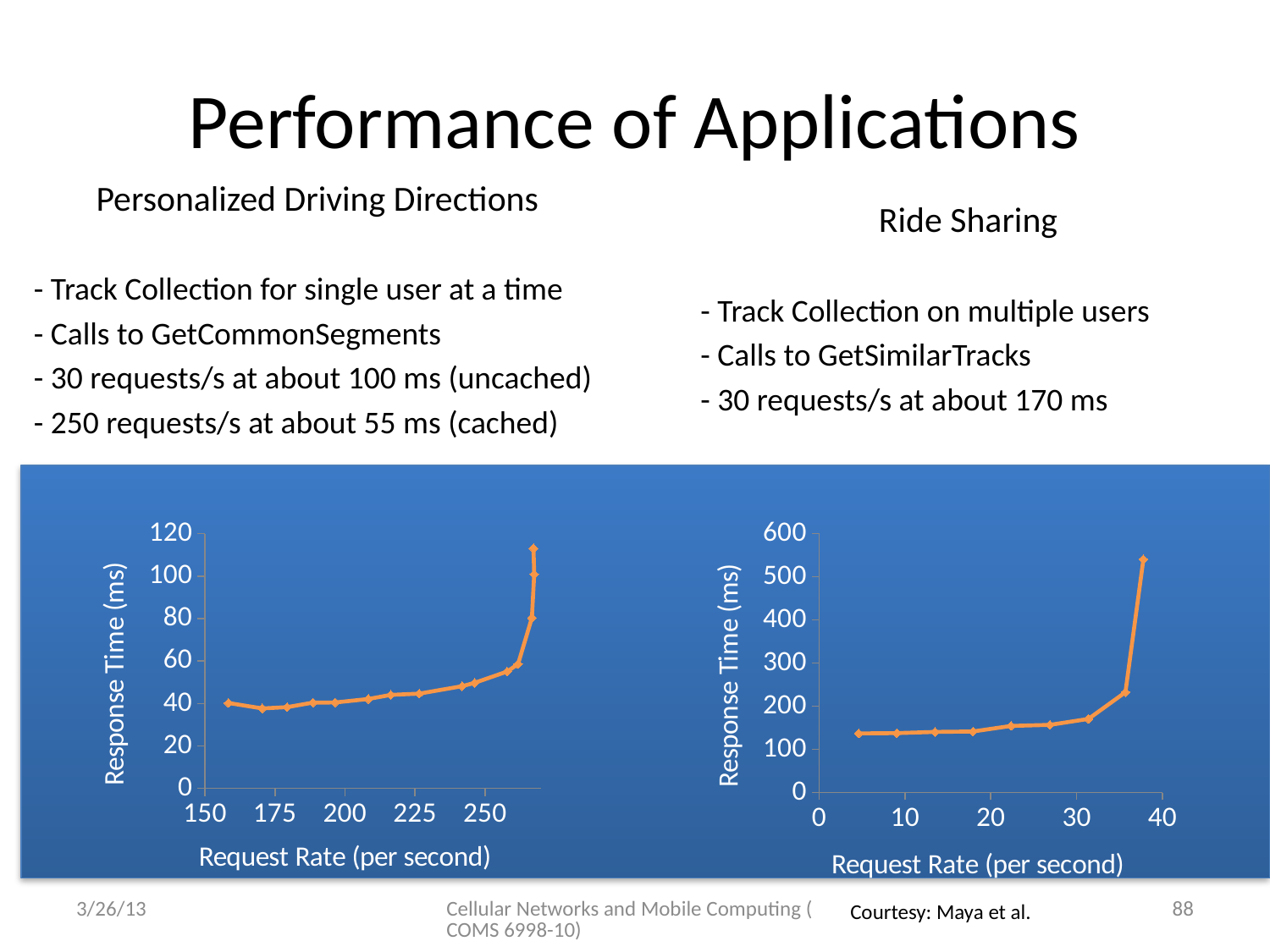
In the left chart, is the response time at the highest plotted request rate larger or smaller than at the lowest plotted request rate? larger In the right chart, is the response time at the lowest plotted request rate greater or less than 200? less What kind of chart is the left chart on the slide? line chart In the left chart, is the highest plotted response time greater or less than 100? greater In the left chart, does the response time overall rise or fall as the request rate increases? rise In the right chart, is the highest plotted response time greater or less than 500? greater In the right chart, does the response time rise or fall as the request rate increases? rise What is the label of the y axis in the right chart? Response Time (ms) What is the label of the x axis in the left chart? Request Rate (per second) In the right chart, is the response time at the lowest plotted request rate larger or smaller than at the highest plotted request rate? smaller What kind of chart is the right chart on the slide? line chart